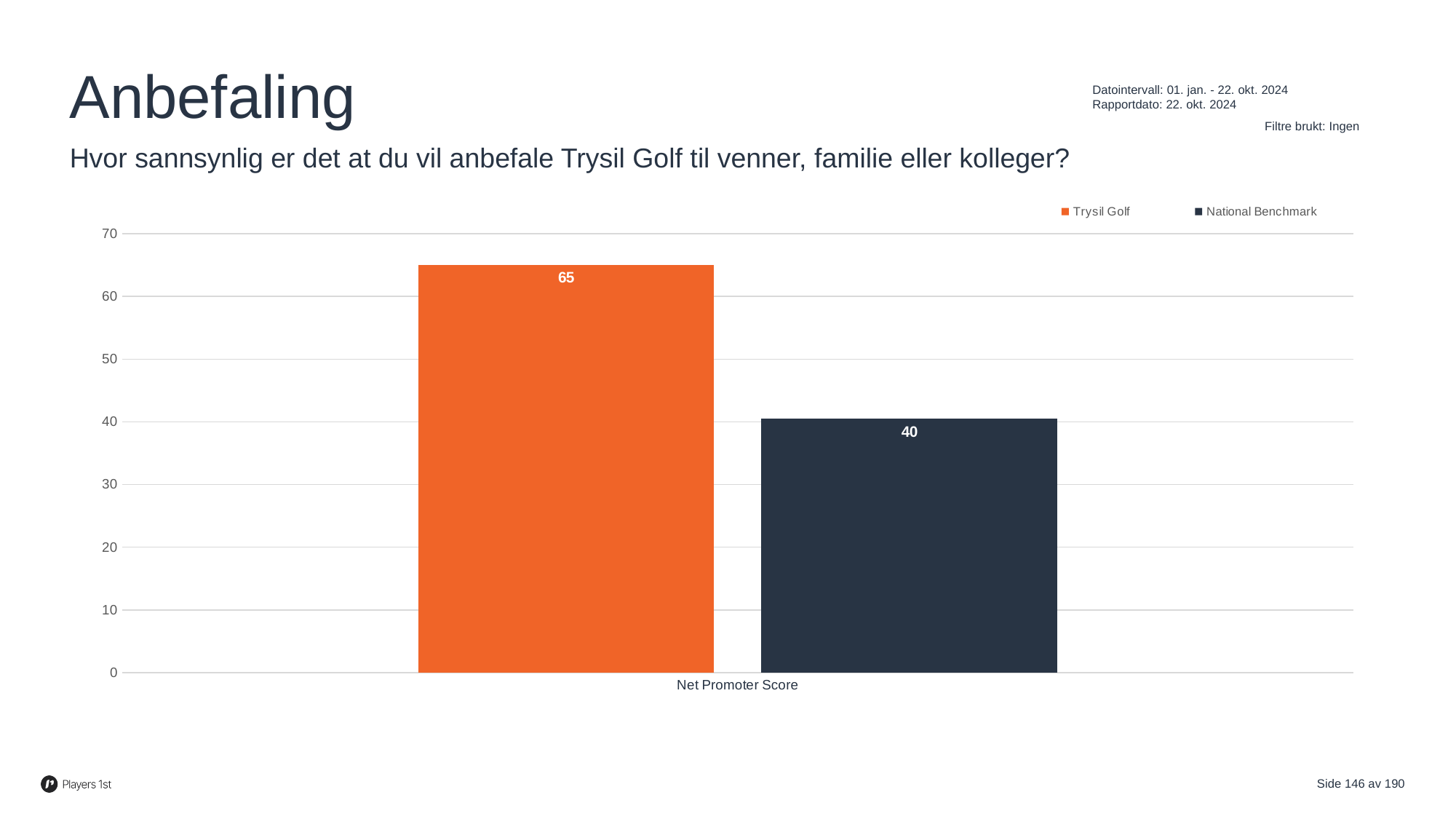
How many series does the legend list? 2 What kind of chart is shown on the slide? Bar chart What is the category label shown on the x axis? Net Promoter Score Which series has the higher Net Promoter Score, Trysil Golf or National Benchmark? Trysil Golf What is the highest value shown on the y axis? 70 Is the value for Trysil Golf greater or less than 60? greater Which series has the lowest value in the chart? National Benchmark What is the Net Promoter Score for Trysil Golf? 65 What colour is the bar for Trysil Golf? Orange What is the Net Promoter Score for the National Benchmark? 40 Is the value for National Benchmark greater or less than 50? less What is the difference between the Trysil Golf score and the National Benchmark score? 25